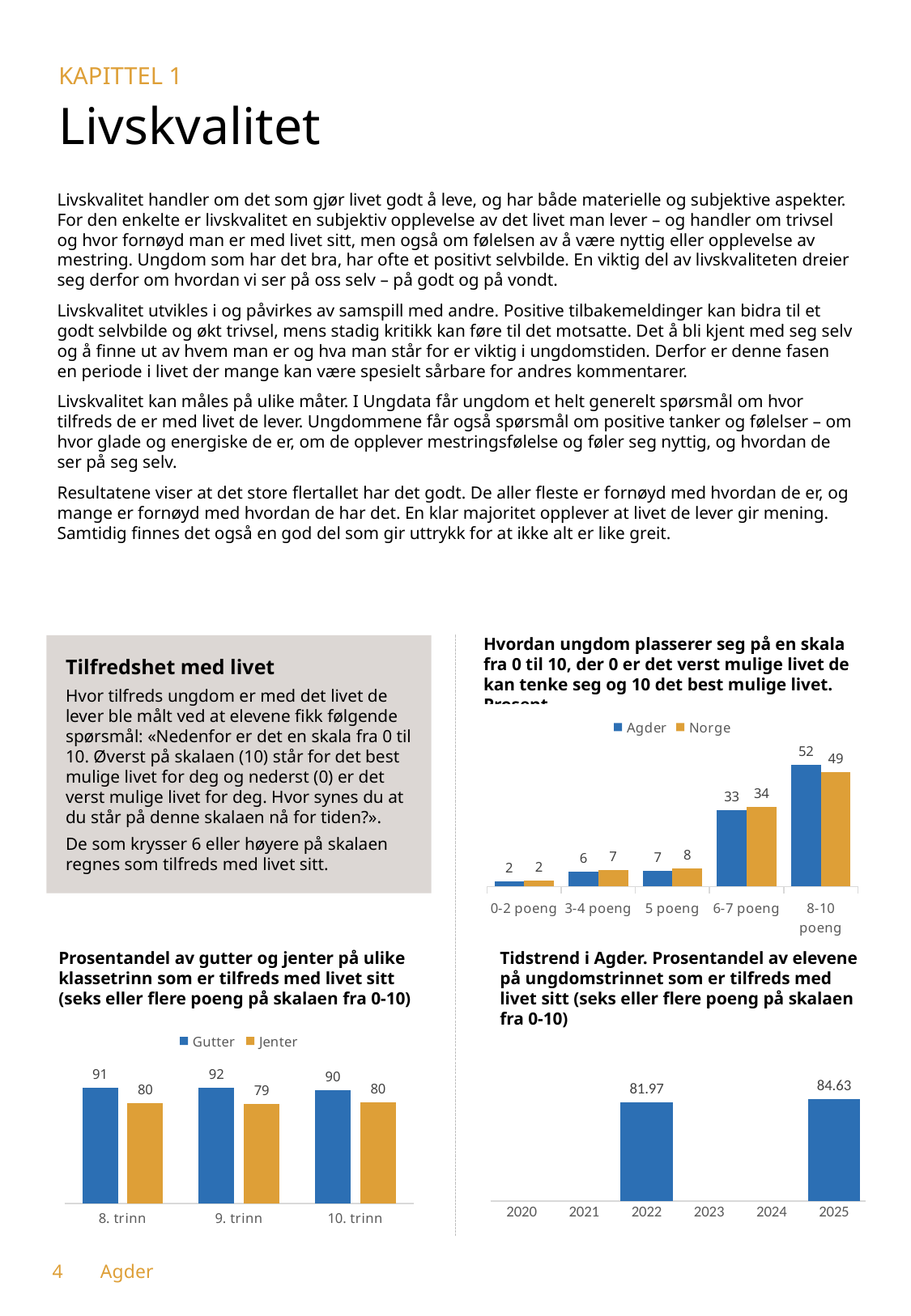
In the chart 'Prosentandel av gutter og jenter på ulike klassetrinn som er tilfreds med livet sitt', which is larger at 10. trinn, Gutter or Jenter? Gutter In the chart 'Prosentandel av gutter og jenter på ulike klassetrinn som er tilfreds med livet sitt', what is the value for Jenter at 9. trinn? 79 In the chart 'Tidstrend i Agder', what is the difference between the 2025 and 2022 values? 2.66 In the chart 'Hvordan ungdom plasserer seg på en skala fra 0 til 10', what is the value for Agder in the 8-10 poeng category? 52 In the chart 'Hvordan ungdom plasserer seg på en skala fra 0 til 10', which category has the highest value for Agder? 8-10 poeng What kind of chart is the 'Tidstrend i Agder' chart? Bar chart In the chart 'Prosentandel av gutter og jenter på ulike klassetrinn som er tilfreds med livet sitt', what is the difference between Gutter and Jenter at 8. trinn? 11 In the chart 'Prosentandel av gutter og jenter på ulike klassetrinn som er tilfreds med livet sitt', how many class levels (categories) are shown? 3 In the chart 'Hvordan ungdom plasserer seg på en skala fra 0 til 10', what is the value for Norge in the 6-7 poeng category? 34 In the chart 'Tidstrend i Agder', what is the value for 2025? 84.63 In the chart 'Hvordan ungdom plasserer seg på en skala fra 0 til 10', what is the difference between Agder and Norge in the 8-10 poeng category? 3 In the chart 'Hvordan ungdom plasserer seg på en skala fra 0 til 10', how many series does the legend list? 2